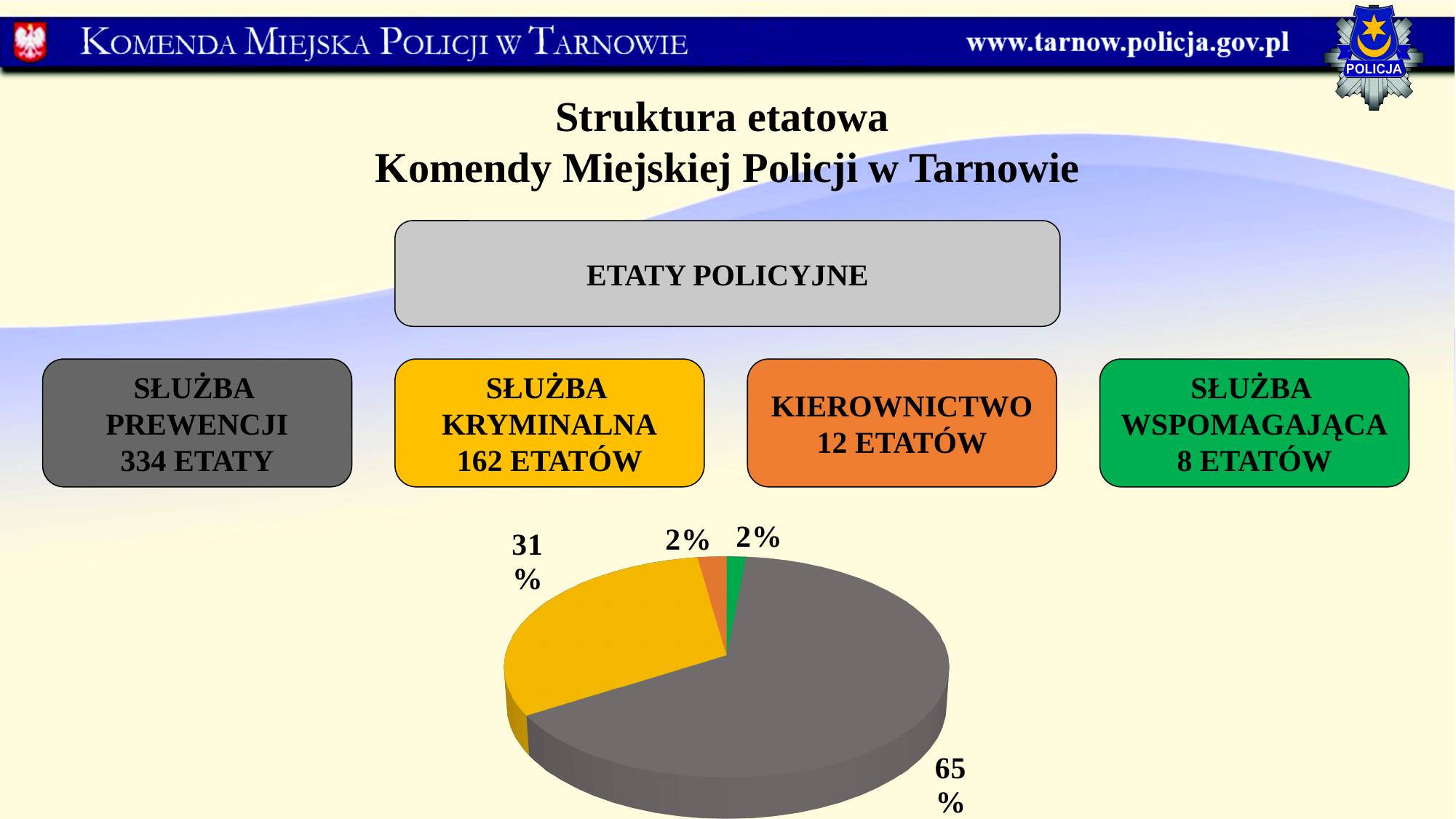
Which slice of the pie chart is the largest? the grey slice (65%) What share of the pie does the orange slice represent? 2% What share of the pie does the green slice represent? 2% How many slices does the pie chart have? 4 What kind of chart is shown on the slide? pie chart Which is larger, the grey slice or the yellow slice? the grey slice Is the share of the yellow slice greater or less than 50%? less What share of the pie does the largest (grey) slice represent? 65% What is the title of the slide containing the pie chart? Struktura etatowa Komendy Miejskiej Policji w Tarnowie How many posts (etaty) does the box for Służba Prewencji show? 334 ETATY What is the difference in percentage points between the grey slice and the yellow slice? 34